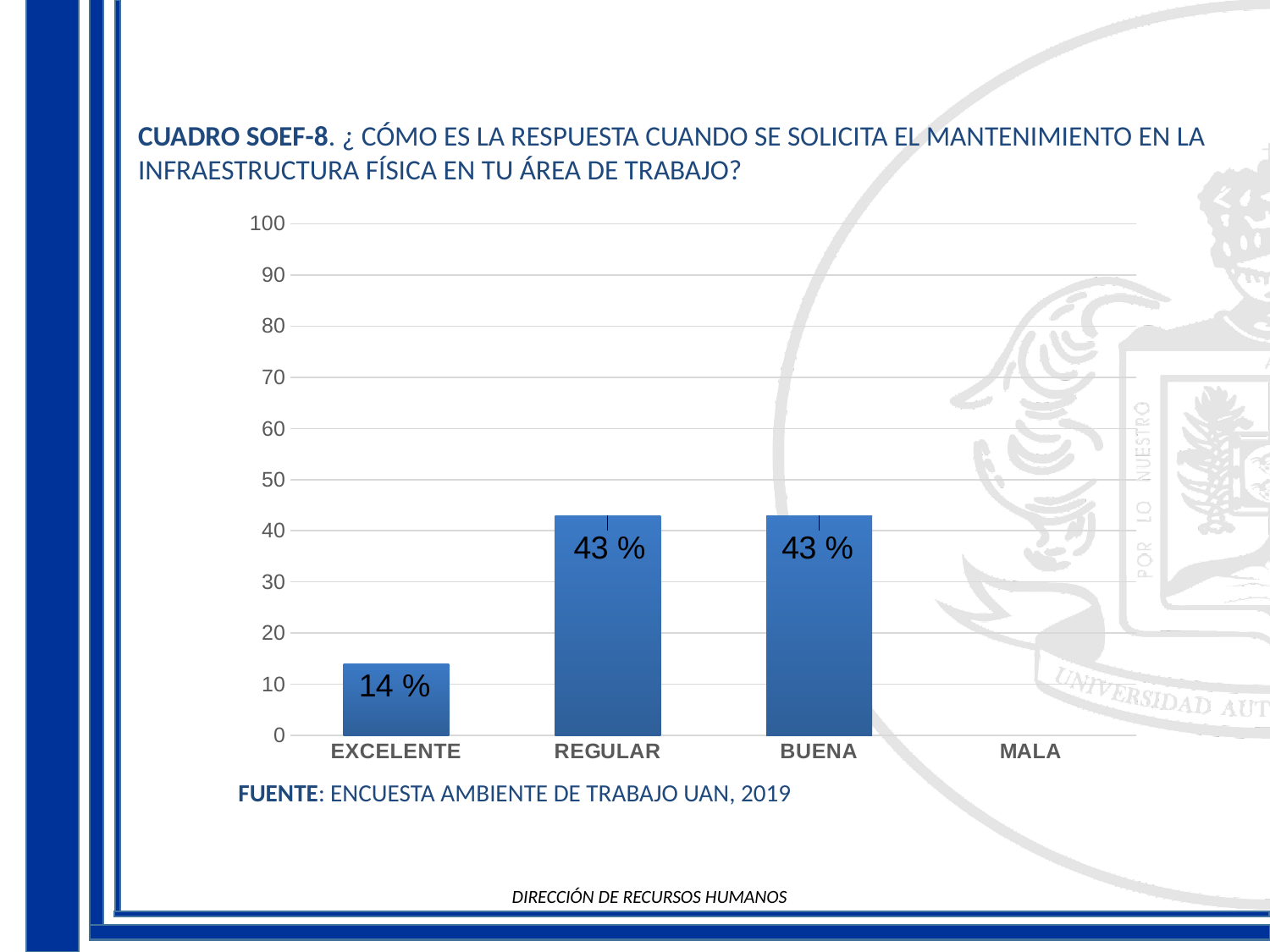
Is the value for BUENA greater or less than 40? greater What is the difference between the value for REGULAR and the value for EXCELENTE? 29 % How many categories are shown on the x axis? 4 What source is cited below the chart? ENCUESTA AMBIENTE DE TRABAJO UAN, 2019 Which is larger, the value for REGULAR or the value for EXCELENTE? REGULAR Which of the labelled bars has the lowest value? EXCELENTE What kind of chart is shown on the slide? bar chart What is the value for EXCELENTE? 14 % What is the value for REGULAR? 43 % What is the value for BUENA? 43 % Is the value for EXCELENTE greater or less than 20? less Which category on the x axis has no visible bar? MALA